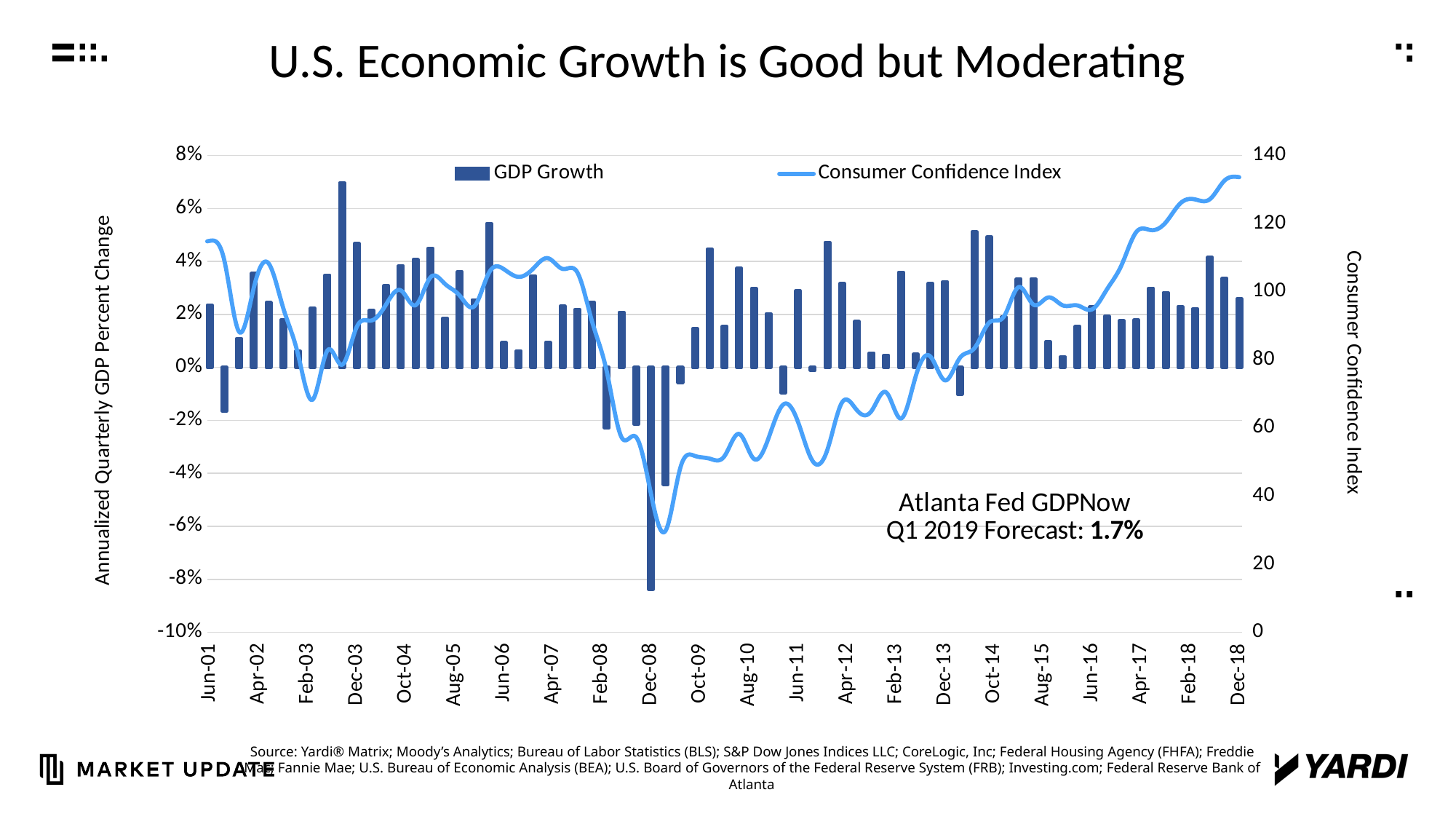
Which series is plotted as bars? GDP Growth Is the Consumer Confidence Index at Jun-01 greater or less than 100? greater What kind of chart is shown on the slide? A combination bar and line chart Is the Consumer Confidence Index at Dec-18 greater or less than 120? greater How many series does the legend list? 2 Which is higher: the Consumer Confidence Index at Dec-18 or at Feb-13? Dec-18 What is the title of the right-hand vertical axis? Consumer Confidence Index Does the Consumer Confidence Index rise or fall between Jun-16 and Dec-18? rise Is the lowest GDP Growth bar greater or less than -6%? less In which labeled period does GDP Growth reach its lowest value? Dec-08